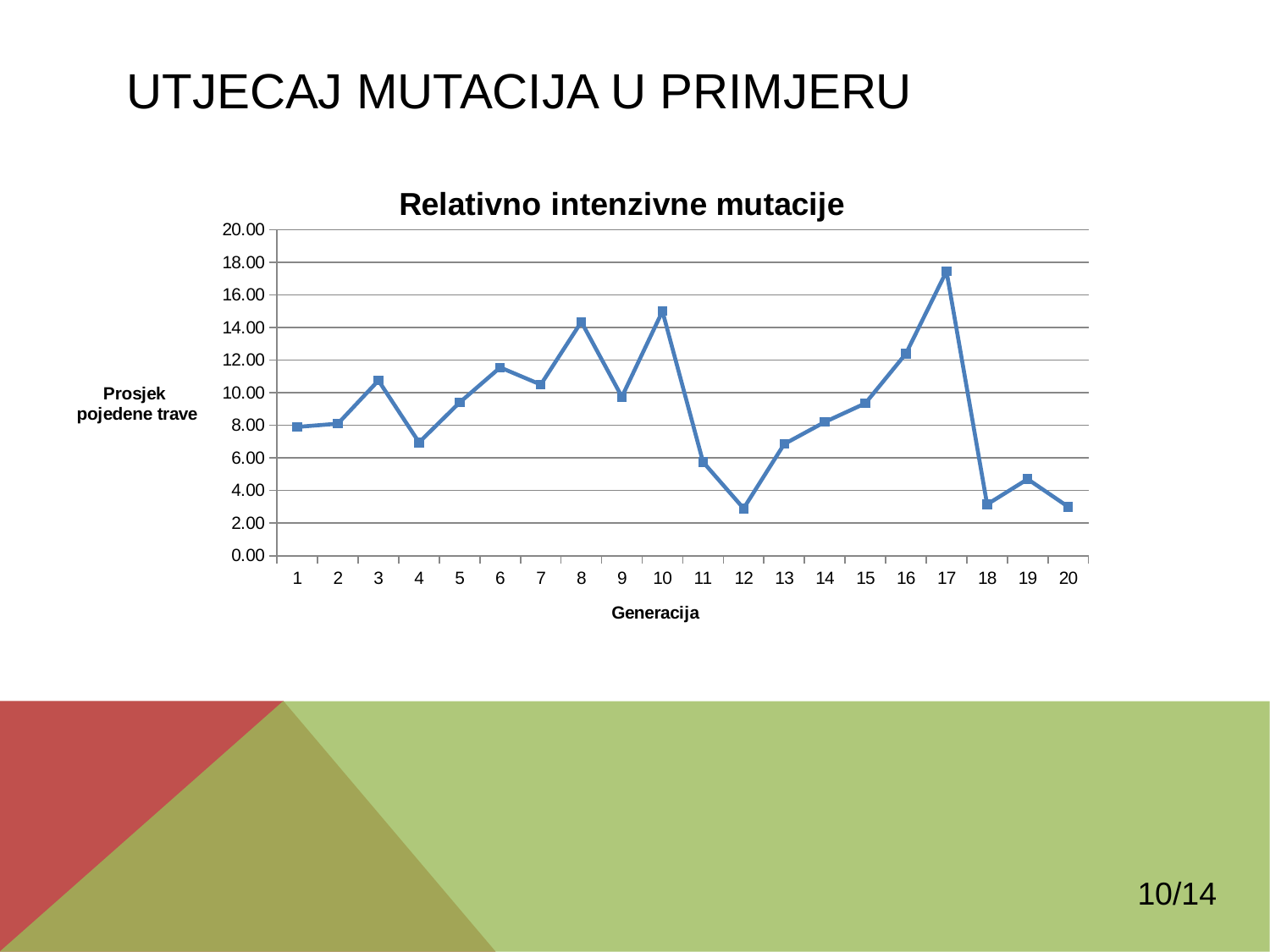
Does the value rise or fall from generation 17 to generation 18? fall What is the label of the x axis of the chart? Generacija Is the value for generation 1 greater or less than 10.00? less How many generations (data points) are plotted on the chart? 20 Is the value for generation 12 greater or less than 4.00? less What is the title of the chart? Relativno intenzivne mutacije Which generation has the highest value on the chart? 17 Which has the larger value, generation 10 or generation 17? generation 17 Is the value for generation 8 greater or less than 12.00? greater What kind of chart is shown on the slide? line chart Which has the larger value, generation 3 or generation 4? generation 3